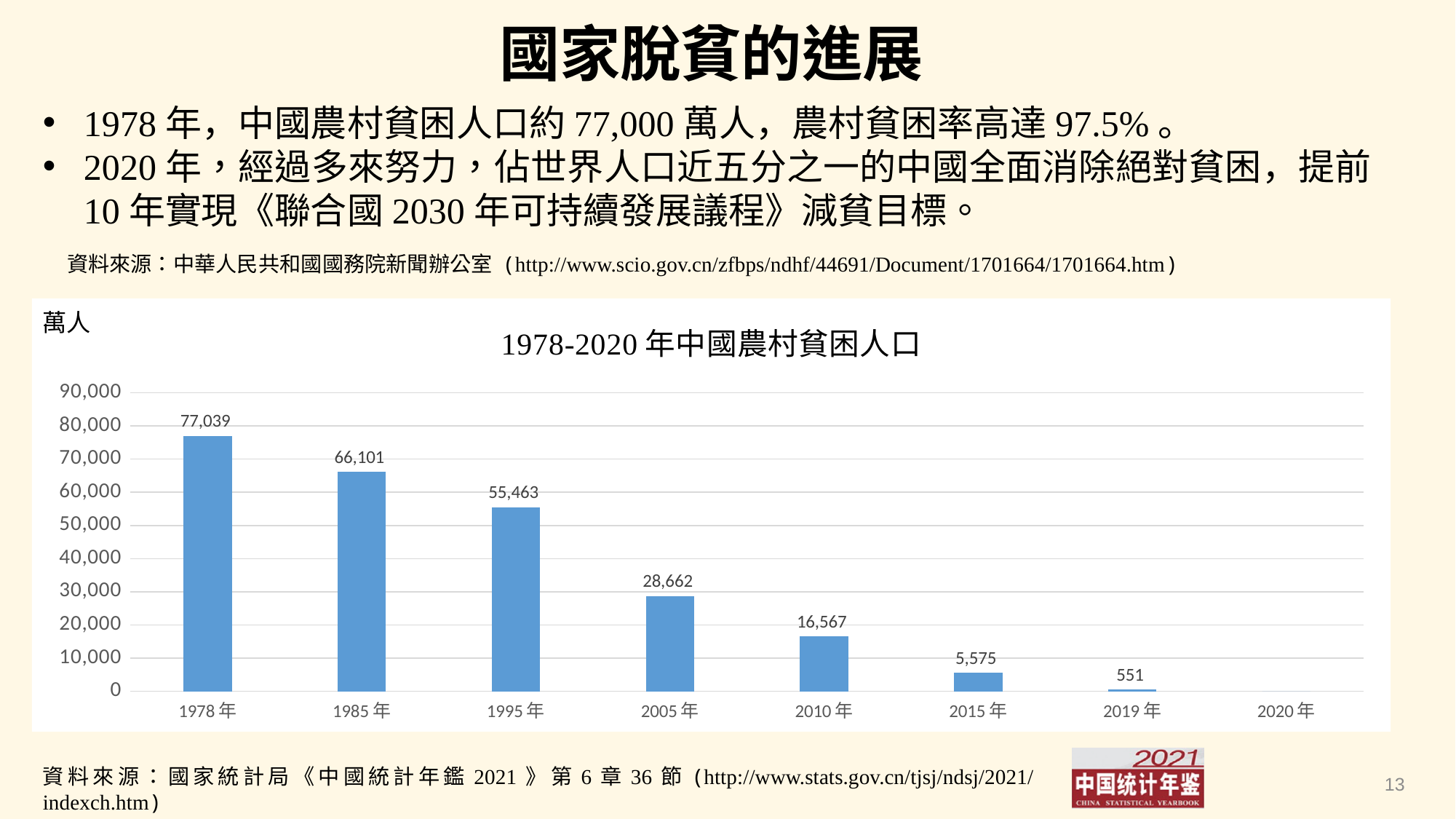
What is the value for 2005年 in the chart? 28,662 Which is larger, the value for 1995年 or the value for 2005年? 1995年 How many years are shown on the x axis of the chart? 8 Do the values rise or fall from 1978年 to 2019年? fall What is the value for 1978年 in the chart? 77,039 Among the years with a data label, which has the lowest value? 2019年 What is the difference between the values for 2005年 and 2010年? 12,095 What is the value for 2019年 in the chart? 551 What kind of chart is shown on the slide? bar chart Is the value for 2015年 greater or less than 10,000? less Which year has the highest value in the chart? 1978年 What is the difference between the values for 1978年 and 1985年? 10,938